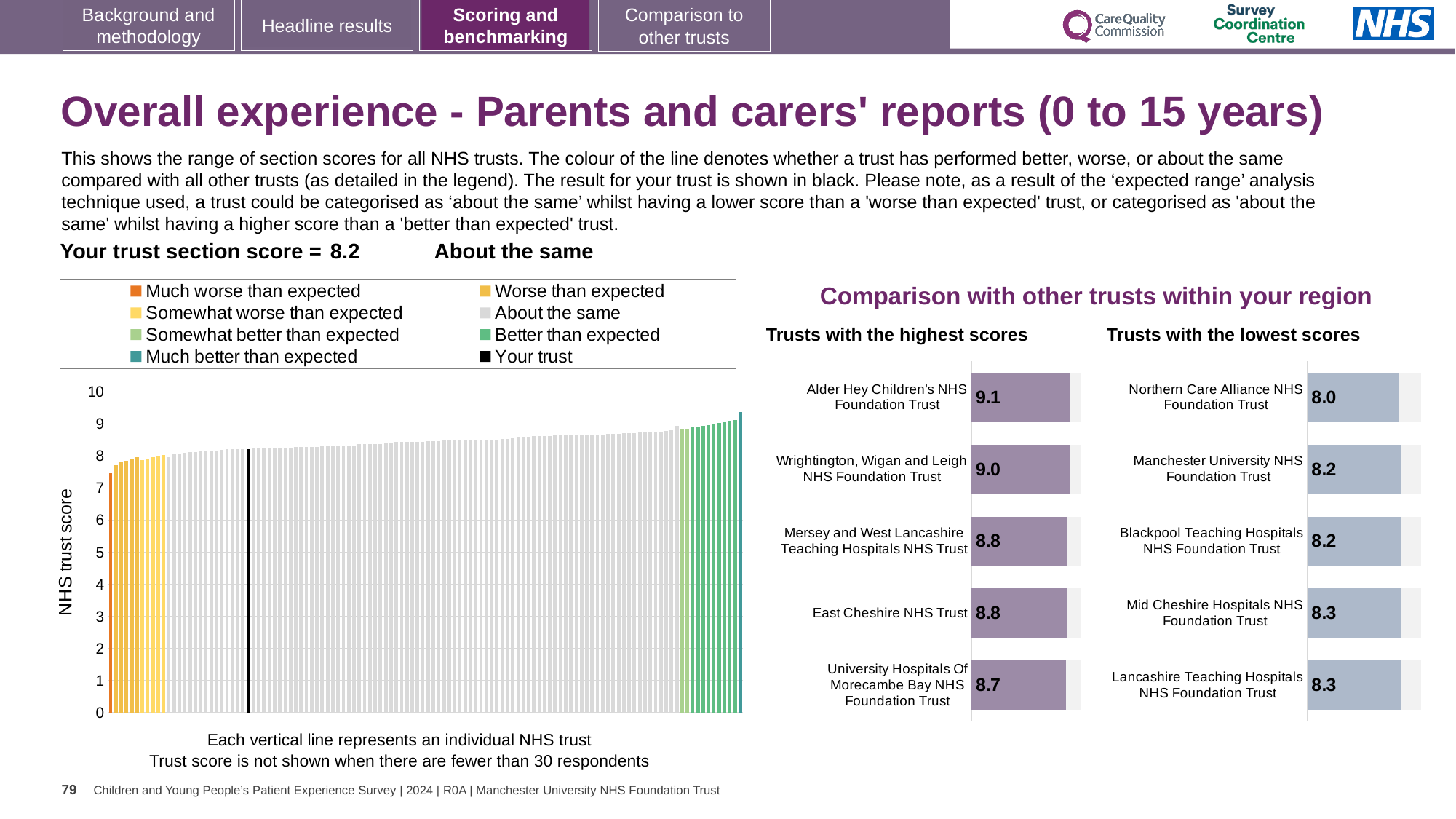
In the 'Trusts with the highest scores' chart, which has the larger score: Wrightington, Wigan and Leigh NHS Foundation Trust or Mersey and West Lancashire Teaching Hospitals NHS Trust? Wrightington, Wigan and Leigh NHS Foundation Trust In the 'Trusts with the highest scores' chart, what is the difference between the scores of Alder Hey Children's NHS Foundation Trust and University Hospitals Of Morecambe Bay NHS Foundation Trust? 0.4 In the 'Trusts with the lowest scores' chart, what is the score for Northern Care Alliance NHS Foundation Trust? 8.0 How many trusts are shown in the 'Trusts with the lowest scores' chart? 5 In the 'Trusts with the highest scores' chart, what is the score for University Hospitals Of Morecambe Bay NHS Foundation Trust? 8.7 In the 'Trusts with the lowest scores' chart, what is the difference between the scores of Mid Cheshire Hospitals NHS Foundation Trust and Northern Care Alliance NHS Foundation Trust? 0.3 What kind of chart is the large chart on the left with the y axis labelled 'NHS trust score'? Bar chart In the 'Trusts with the highest scores' chart, what is the score for Alder Hey Children's NHS Foundation Trust? 9.1 How many entries does the legend above the large chart on the left list? 8 In the large chart on the left, is the value of the tallest bar greater or less than 9? greater In the 'Trusts with the lowest scores' chart, which trust has the lowest score? Northern Care Alliance NHS Foundation Trust In the 'Trusts with the highest scores' chart, which trust has the highest score? Alder Hey Children's NHS Foundation Trust